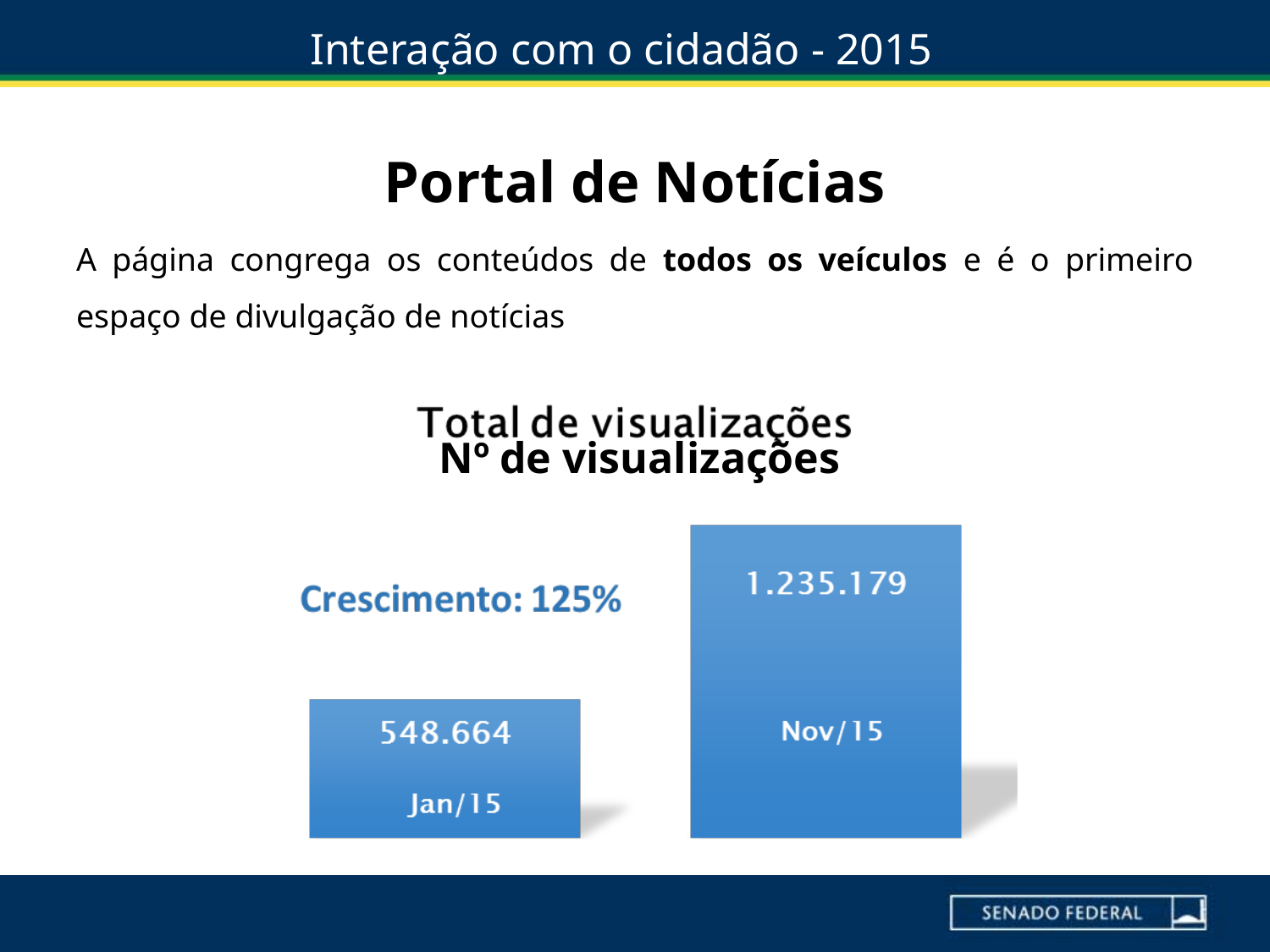
How many bars are plotted in the chart? 2 Which period has the higher number of views, Jan/15 or Nov/15? Nov/15 Do the values rise or fall from Jan/15 to Nov/15? rise What is the combined total of views for Jan/15 and Nov/15? 1.783.843 What is the number of views shown for Jan/15? 548.664 What colour are the bars in the chart? blue What is the difference in views between Nov/15 and Jan/15? 686.515 What is the number of views shown for Nov/15? 1.235.179 Which period has the lower number of views? Jan/15 What kind of chart is shown on the slide? bar chart What growth percentage is printed on the chart? 125% Is the value for Jan/15 larger or smaller than the value for Nov/15? smaller